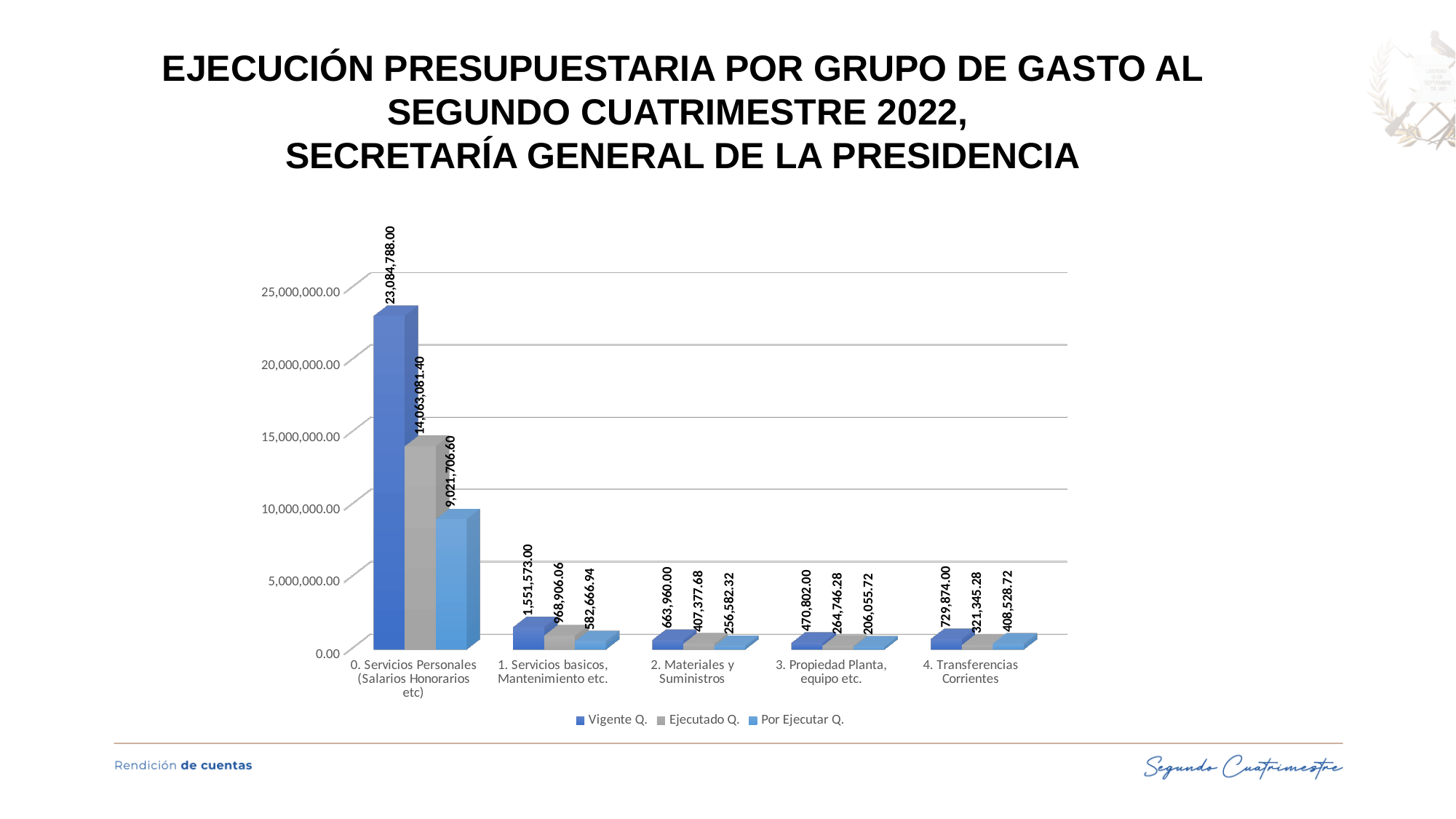
Which category has the highest Vigente Q. value? 0. Servicios Personales (Salarios Honorarios etc) What is the difference between the Vigente Q. and Ejecutado Q. values for 1. Servicios basicos, Mantenimiento etc.? 582,666.94 Which category has the lowest Vigente Q. value? 3. Propiedad Planta, equipo etc. What is the Vigente Q. value for 0. Servicios Personales (Salarios Honorarios etc)? 23,084,788.00 How many expense group categories are shown on the x axis? 5 What kind of chart is shown on the slide? Bar chart Is the Ejecutado Q. value for 0. Servicios Personales greater or less than 15,000,000.00? less What is the Por Ejecutar Q. value for 4. Transferencias Corrientes? 408,528.72 What is the Ejecutado Q. value for 3. Propiedad Planta, equipo etc.? 264,746.28 How many series does the legend list? 3 What is the Ejecutado Q. value for 2. Materiales y Suministros? 407,377.68 For 4. Transferencias Corrientes, which is larger: Ejecutado Q. or Por Ejecutar Q.? Por Ejecutar Q.